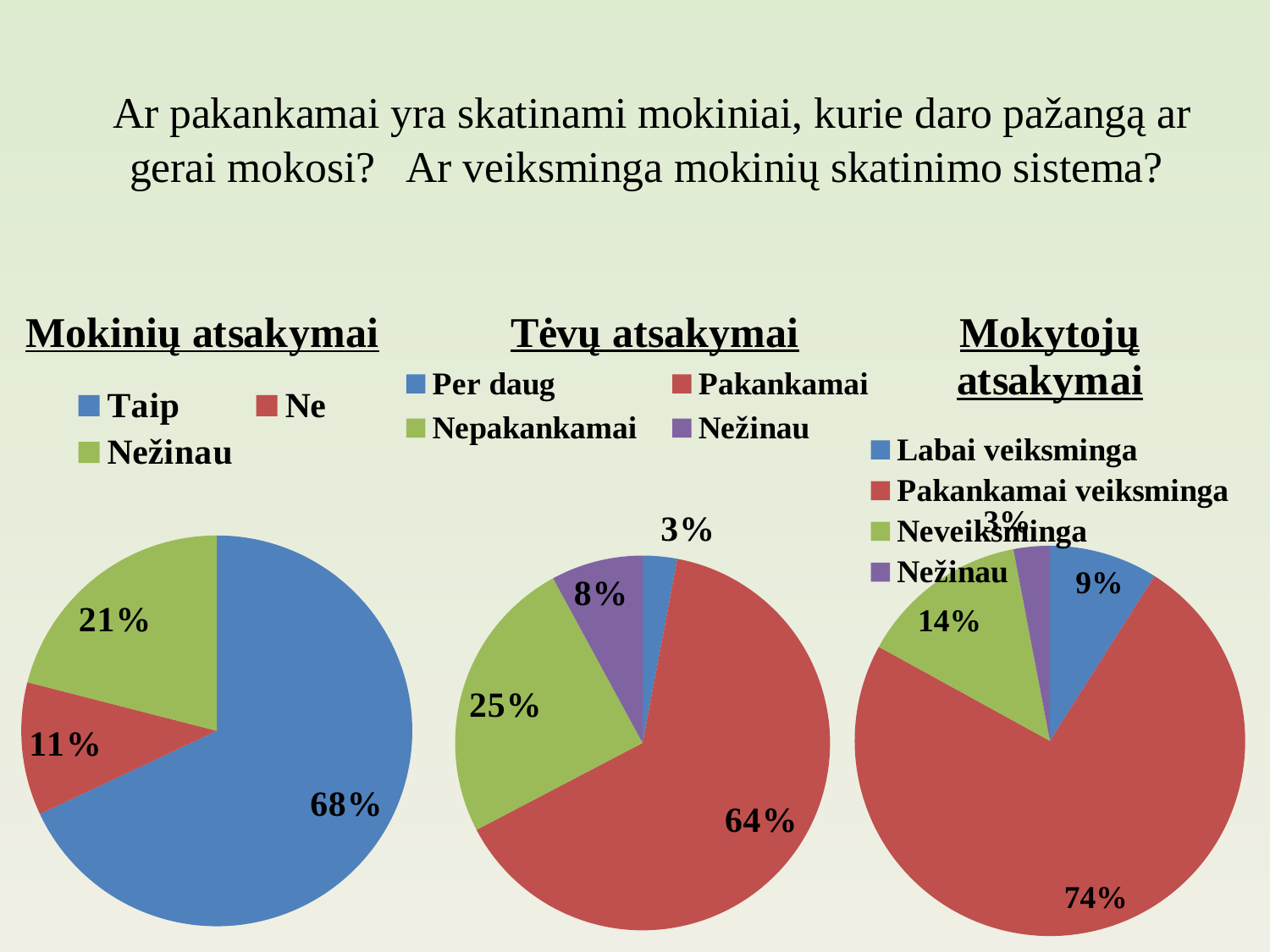
In the 'Tėvų atsakymai' chart, what percentage is shown for 'Per daug'? 3% In the 'Mokytojų atsakymai' chart, what percentage is shown for 'Pakankamai veiksminga'? 74% What type of chart is used for the 'Mokinių atsakymai' data? Pie chart In the 'Tėvų atsakymai' chart, what percentage is shown for 'Pakankamai'? 64% In the 'Mokinių atsakymai' chart, what percentage is shown for 'Taip'? 68% In the 'Mokinių atsakymai' chart, what is the difference between the 'Taip' and 'Ne' percentages? 57% In the 'Mokytojų atsakymai' chart, which category has the largest slice? Pakankamai veiksminga In the 'Mokinių atsakymai' chart, which category has the smallest slice? Ne In the 'Tėvų atsakymai' chart, which is larger, 'Nepakankamai' or 'Nežinau'? Nepakankamai In the 'Mokinių atsakymai' chart, what percentage is shown for 'Nežinau'? 21% In the 'Mokytojų atsakymai' chart, what percentage is shown for 'Neveiksminga'? 14% How many categories does the legend of the 'Tėvų atsakymai' chart list? 4